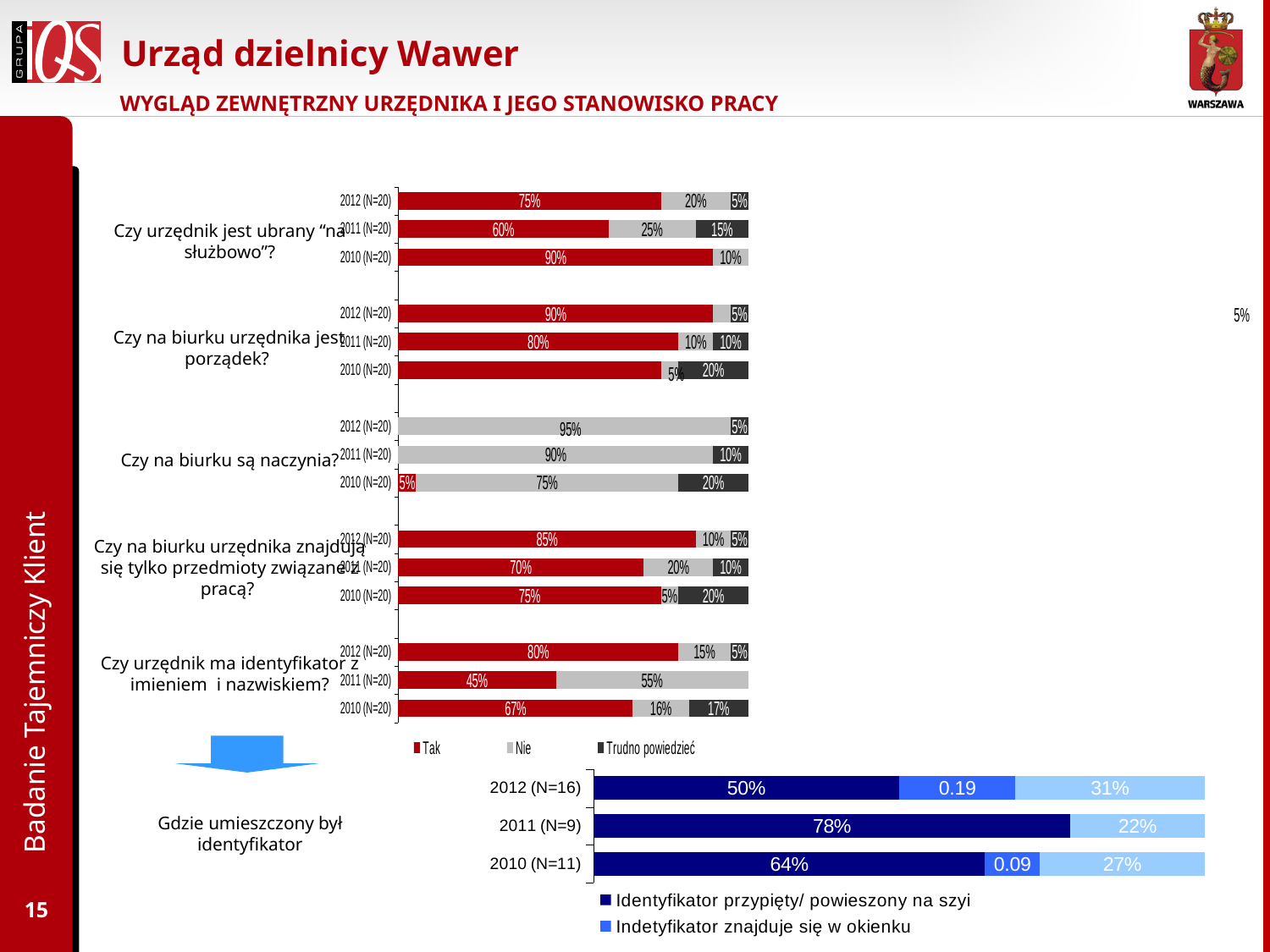
In the top chart, what is the 'Tak' value for 'Czy urzędnik jest ubrany "na służbowo"?' in 2012 (N=20)? 75% In the top chart, which is larger for 'Czy na biurku urzędnika znajdują się tylko przedmioty związane z pracą?': the 'Tak' value in 2012 or in 2010? 2012 In the top chart, what is the difference between the 'Tak' values for 'Czy urzędnik jest ubrany "na służbowo"?' in 2012 and 2011? 15 percentage points In the 'Gdzie umieszczony był identyfikator' chart, what is the value for 'Identyfikator przypięty/ powieszony na szyi' in 2011 (N=9)? 78% In the top chart, what is the 'Tak' value for 'Czy na biurku urzędnika jest porządek?' in 2012 (N=20)? 90% In the top chart, which year has the highest 'Tak' value for 'Czy urzędnik ma identyfikator z imieniem i nazwiskiem?'? 2012 (N=20) In the top chart, what is the 'Tak' value for 'Czy urzędnik ma identyfikator z imieniem i nazwiskiem?' in 2011 (N=20)? 45% In the top chart, what is the 'Nie' value for 'Czy na biurku są naczynia?' in 2012 (N=20)? 95% In the 'Gdzie umieszczony był identyfikator' chart, what is the value for 'Indetyfikator znajduje się w okienku' in 2012 (N=16)? 0.19 In the 'Gdzie umieszczony był identyfikator' chart, which year has the highest value for 'Identyfikator przypięty/ powieszony na szyi'? 2011 (N=9) How many series does the legend of the top chart list? 3 What kind of chart is the top chart? Stacked bar chart